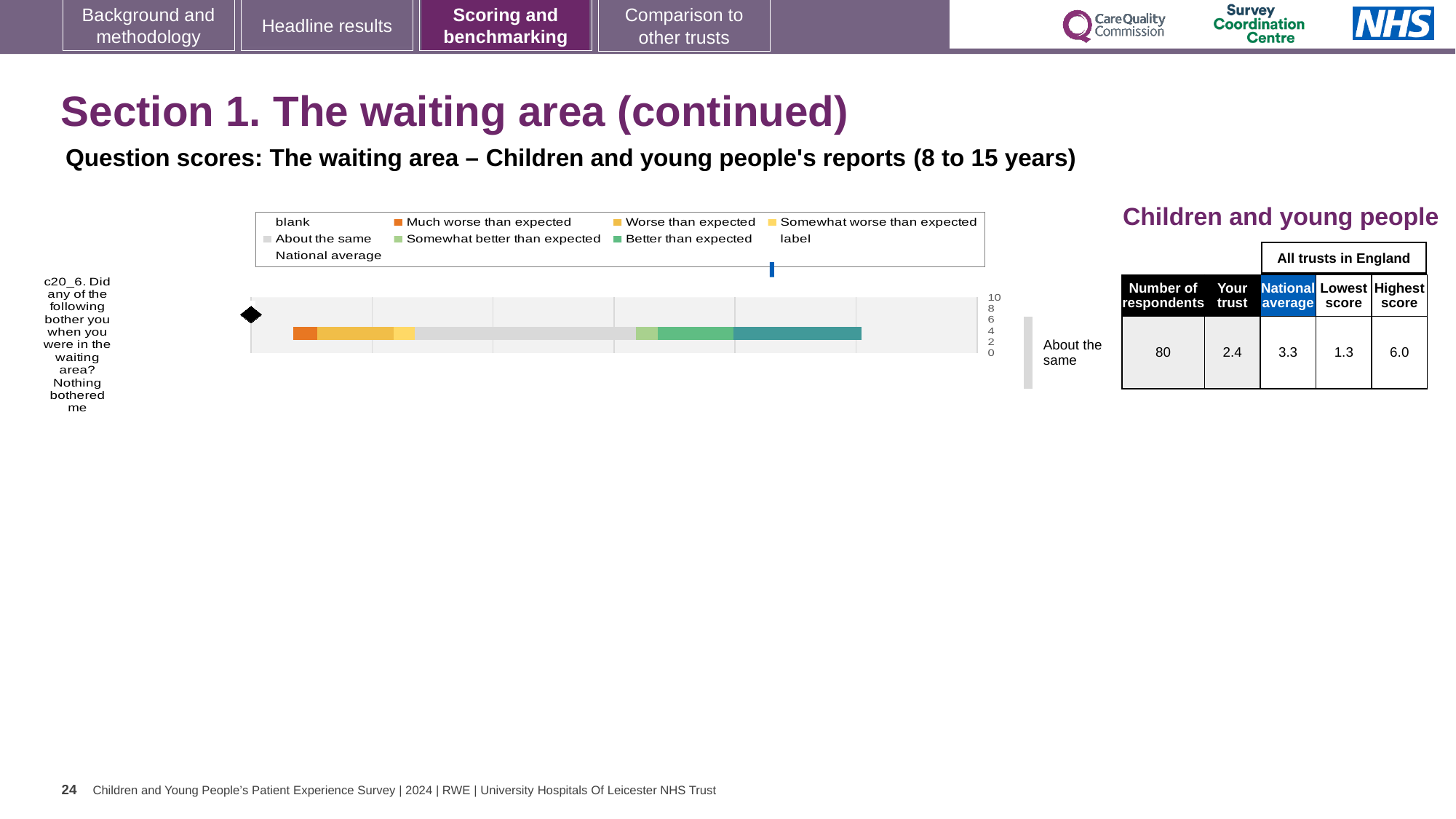
What is the lowest score among all trusts in England for question c20_6? 1.3 Which is larger for question c20_6, the 'Your trust' score or the national average? National average What benchmark category label is shown next to the bar for question c20_6? About the same What is the national average score for question c20_6? 3.3 Which question is plotted on the chart? c20_6. Did any of the following bother you when you were in the waiting area? Nothing bothered me What is the highest score among all trusts in England for question c20_6? 6.0 How many respondents answered question c20_6? 80 How many survey questions (categories) are plotted on the chart? 1 What is the difference between the national average (3.3) and the 'Your trust' score (2.4) for question c20_6? 0.9 What is the difference between the highest score (6.0) and the lowest score (1.3) for question c20_6? 4.7 What is the 'Your trust' score for question c20_6? 2.4 What kind of chart is shown on the slide? bar chart